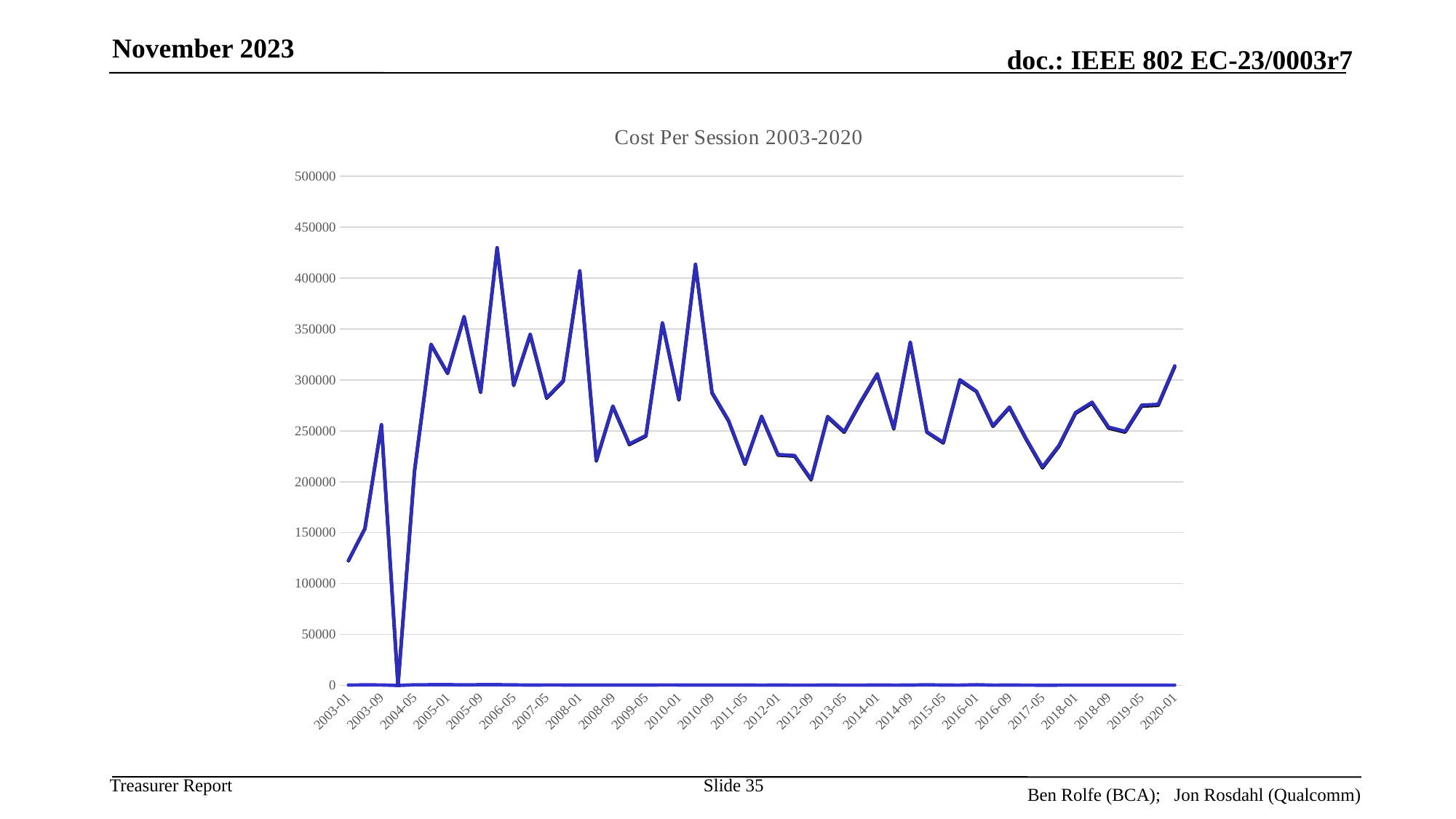
Is the value for 2011-05 greater or less than 250000? less Which is larger, the value for 2003-01 or the value for 2020-01? 2020-01 Is the value for 2018-01 greater or less than 250000? greater What is the title of the chart? Cost Per Session 2003-2020 Does the line rise or fall between 2003-01 and 2003-09? rise Is the value for 2007-05 greater or less than 300000? less What is the highest value shown on the y axis? 500000 Which labelled date on the x axis has the lowest cost per session? 2003-01 What kind of chart is shown on the slide? line chart